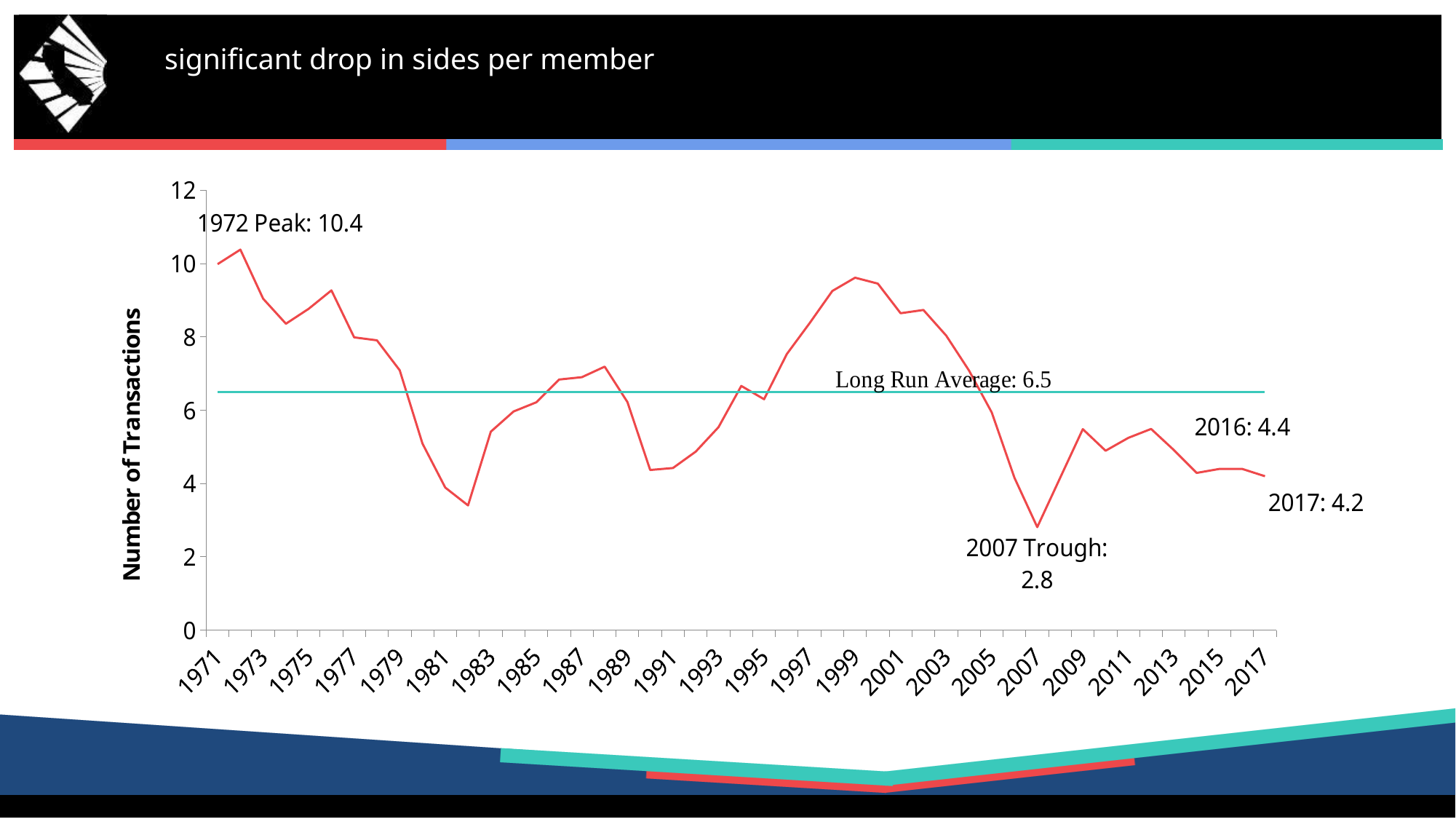
What is the number of transactions in 2016? 4.4 What is the number of transactions in 2017? 4.2 Is the value for 1999 greater or less than 8? greater In which year does the line reach its highest value? 1972 Which is larger, the value for 2016 or the value for 2017? 2016 What is the value of the 1972 peak? 10.4 What is the label of the y axis? Number of Transactions What is the long run average shown on the chart? 6.5 What kind of chart is shown on the slide? line chart In which year does the line reach its lowest value? 2007 What is the difference between the 1972 peak and the 2007 trough? 7.6 What is the value of the 2007 trough? 2.8